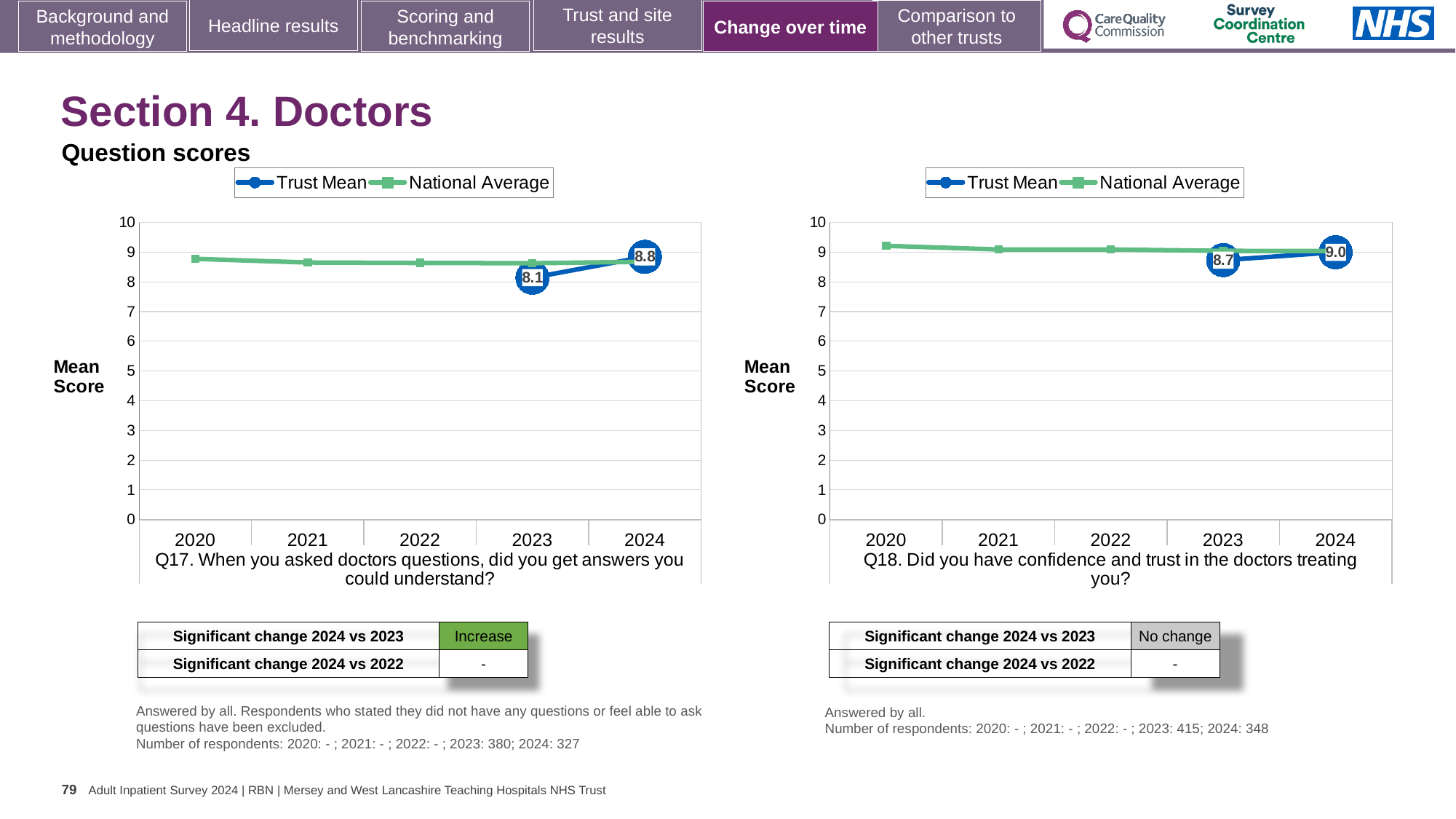
In the Q17 chart (left), what is the Trust Mean score for 2024? 8.8 In the Q17 chart (left), by how much did the Trust Mean change from 2023 to 2024? 0.7 In the Q17 chart (left), did the Trust Mean rise or fall from 2023 to 2024? rise What type of chart is used for Q18 (right)? line chart How many years are shown on the x axis of the Q17 chart (left)? 5 In the Q17 chart (left), is the National Average for 2020 greater or less than 8? greater In the Q18 chart (right), what is the Trust Mean score for 2023? 8.7 In the Q18 chart (right), what is the difference between the Trust Mean in 2024 and in 2023? 0.3 In the Q17 chart (left), what is the Trust Mean score for 2023? 8.1 How many series does the legend of the Q18 chart (right) list? 2 In the Q18 chart (right), is the Trust Mean for 2024 higher or lower than for 2023? higher In the Q18 chart (right), what is the Trust Mean score for 2024? 9.0